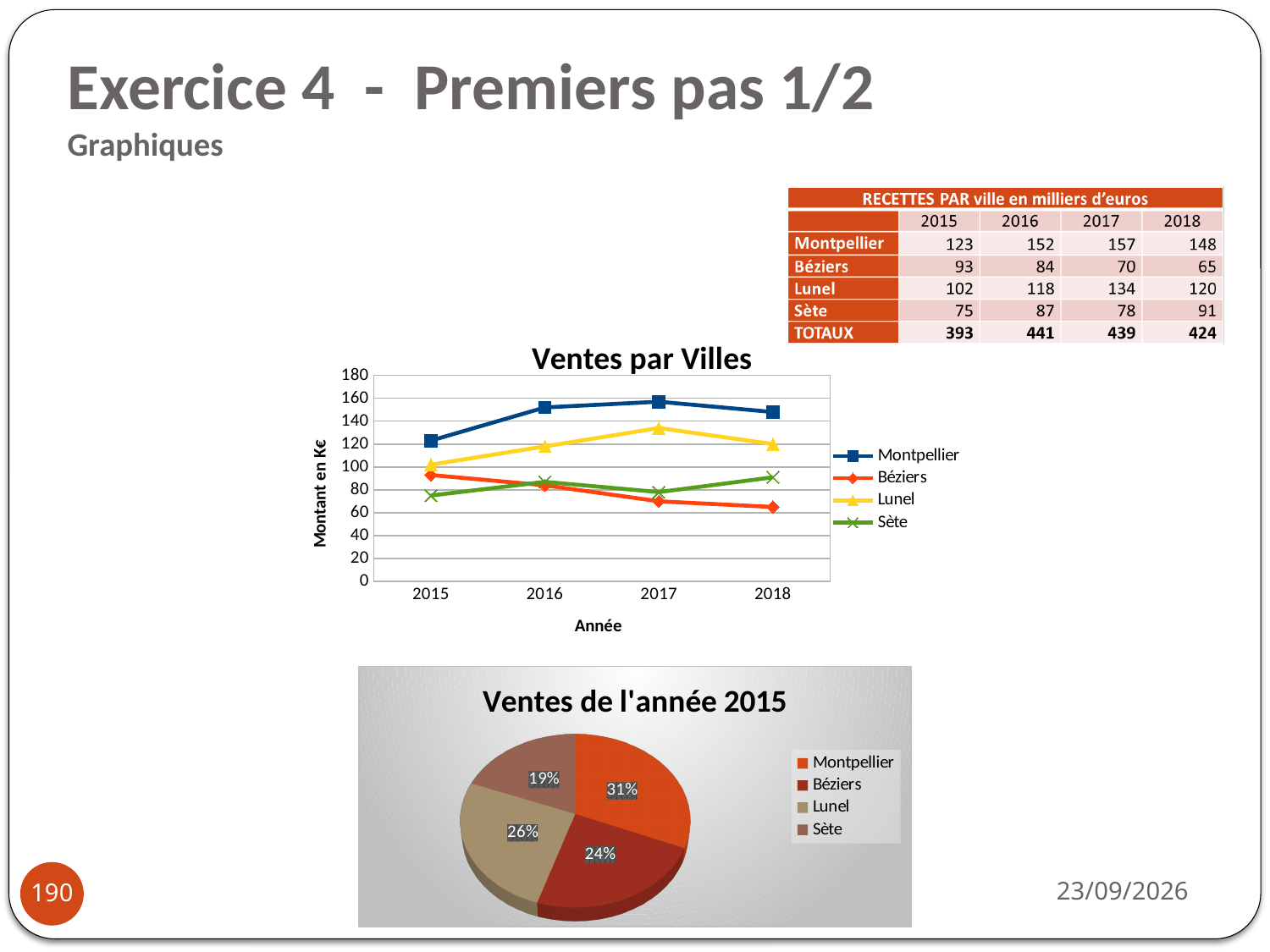
In the 'Ventes par Villes' chart, how many years are shown on the x axis? 4 In the 'Ventes par Villes' chart, which city has the lowest value in 2018? Béziers In the 'Ventes de l'année 2015' pie chart, what share does Montpellier have? 31% In the 'Ventes par Villes' chart, how many series does the legend list? 4 What kind of chart is 'Ventes de l'année 2015'? pie chart In the 'Ventes par Villes' chart, does the Béziers line rise or fall from 2015 to 2018? fall In the 'Ventes de l'année 2015' pie chart, which city has the smallest slice? Sète In the 'Ventes par Villes' chart, which city has the highest value in 2017? Montpellier In the 'Ventes par Villes' chart, is the value for Béziers in 2018 greater or less than 80? less In the 'Ventes par Villes' chart, is the value for Montpellier in 2016 greater or less than 140? greater What kind of chart is 'Ventes par Villes'? line chart In the 'Ventes par Villes' chart, which is larger in 2015: Lunel or Sète? Lunel